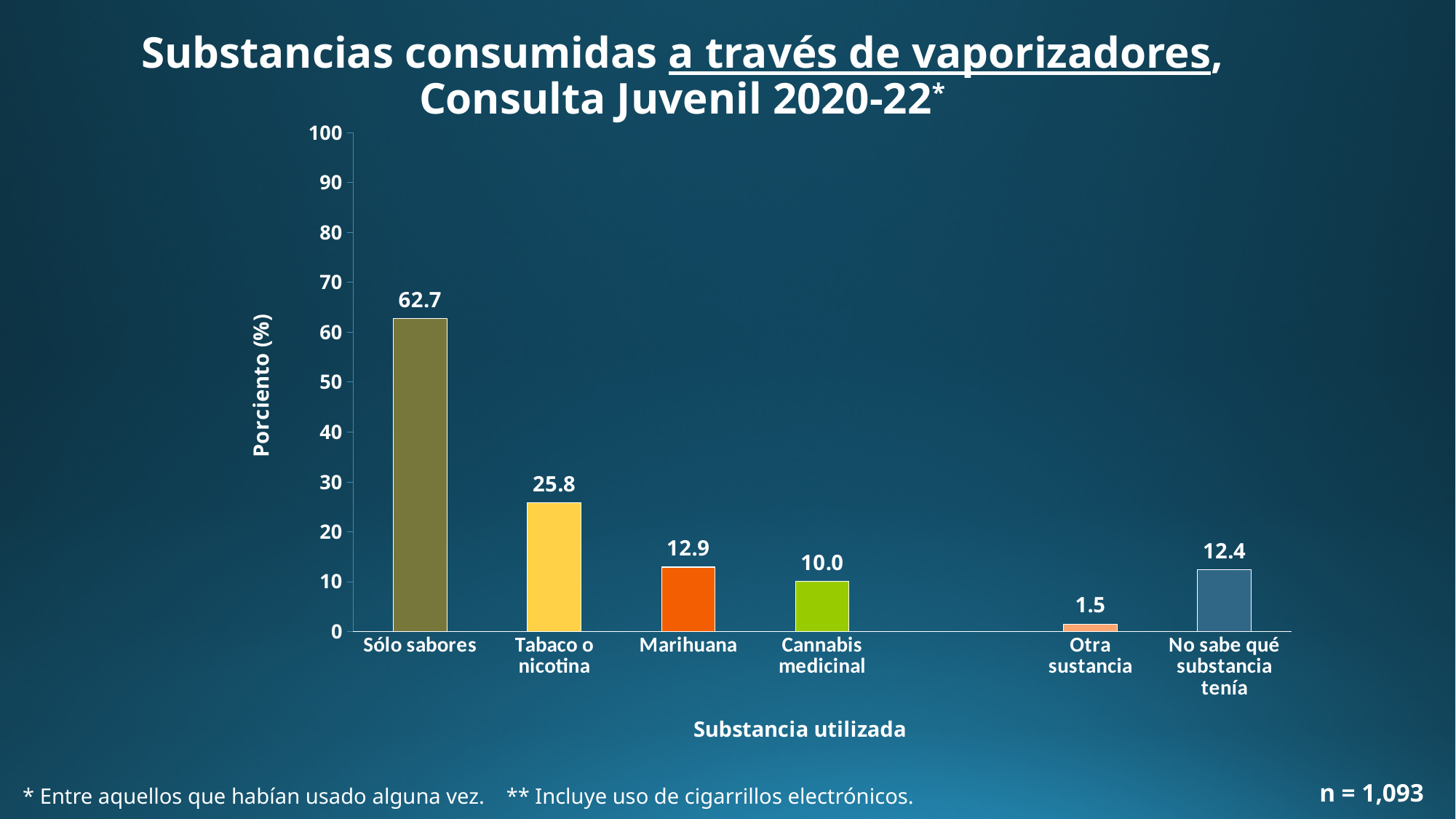
How many categories are shown on the x axis? 6 What kind of chart is shown on the slide? bar chart What is the value for Tabaco o nicotina? 25.8 Which category has the lowest value? Otra sustancia What is the value for Sólo sabores? 62.7 Which category has the highest value? Sólo sabores What is the value for Marihuana? 12.9 Is the value for Sólo sabores greater or less than 50? greater What is the difference between the values for Sólo sabores and Tabaco o nicotina? 36.9 Which is larger, the value for Cannabis medicinal or the value for No sabe qué substancia tenía? No sabe qué substancia tenía What is the label of the y axis? Porciento (%) What is the value for Otra sustancia? 1.5